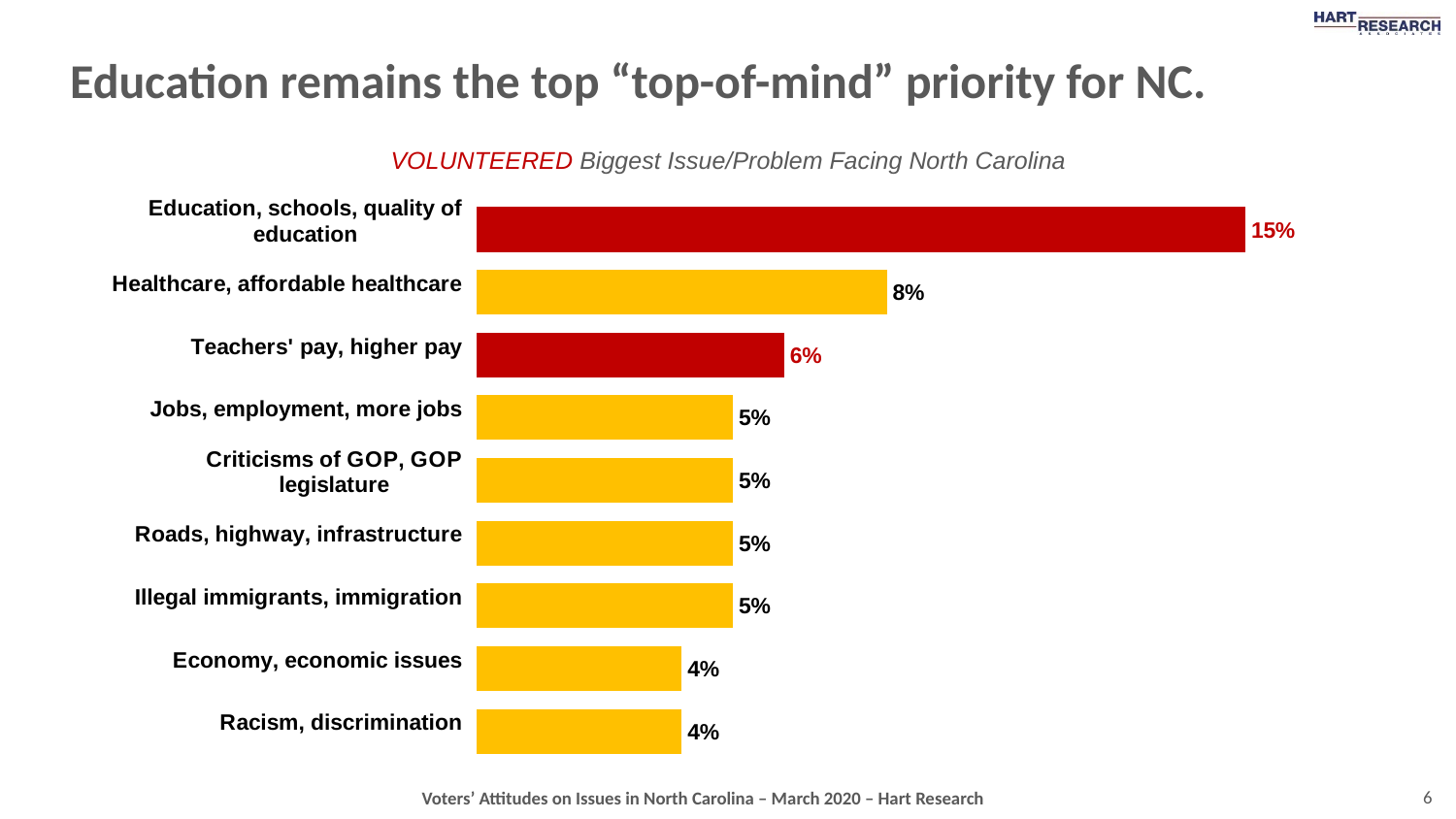
What is the value shown for "Racism, discrimination"? 4% What is the value shown for "Teachers' pay, higher pay"? 6% Which has a larger value: "Jobs, employment, more jobs" or "Economy, economic issues"? Jobs, employment, more jobs What is the value shown for "Healthcare, affordable healthcare"? 8% What is the difference in percentage points between "Education, schools, quality of education" and "Healthcare, affordable healthcare"? 7 What percentage of respondents volunteered "Education, schools, quality of education" as the biggest issue facing North Carolina? 15% What is the difference in percentage points between "Healthcare, affordable healthcare" and "Teachers' pay, higher pay"? 2 How many issue categories are shown on the chart? 9 Which issue has the highest percentage on the chart? Education, schools, quality of education What kind of chart is shown on the slide? Bar chart How many categories on the chart have a value of 5%? 4 Which two bars on the chart are coloured red rather than yellow? Education, schools, quality of education and Teachers' pay, higher pay